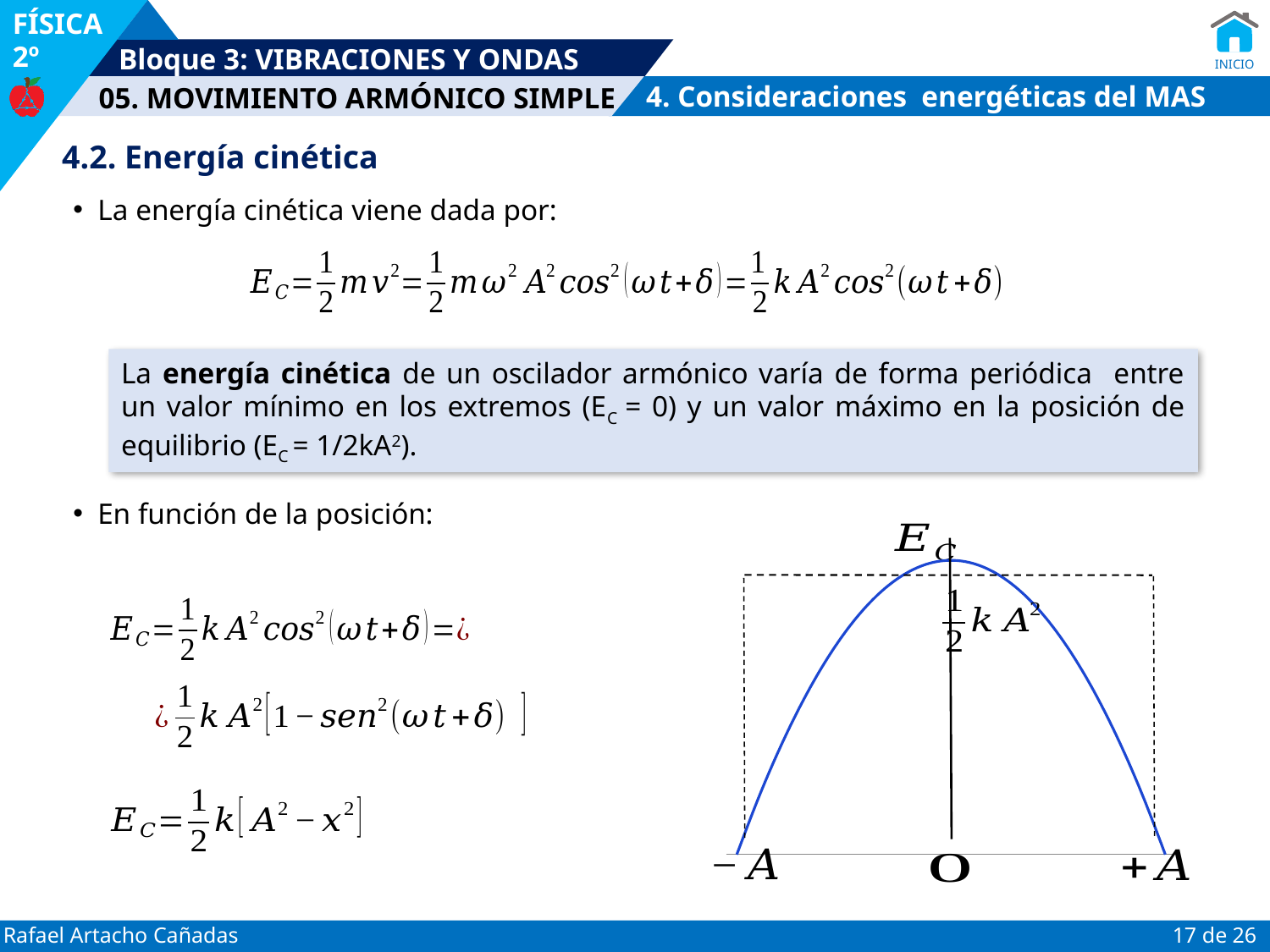
In the chart at the bottom right, what are the three labels marked along the horizontal axis? −A, O, +A In the chart at the bottom right, what is the value of Ec at x = +A? 0 In the chart at the bottom right, does Ec rise or fall as x goes from −A to O? Rises In the chart at the bottom right, which is larger: Ec at O or Ec at −A? Ec at O In the chart at the bottom right, at which position does the curve reach its maximum? O In the chart at the bottom right, at which positions does the curve reach its minimum? −A and +A In the chart at the bottom right, what quantity is plotted on the vertical axis? Ec What kind of chart is shown at the bottom right of the slide? A line chart (a curve of Ec versus position) In the chart at the bottom right, how many curves (series) are plotted? 1 In the chart at the bottom right, does Ec rise or fall as x goes from O to +A? Falls In the chart at the bottom right, what is the maximum value of Ec, as labelled on the chart? 1/2 kA² In the chart at the bottom right, what colour is the plotted curve? Blue